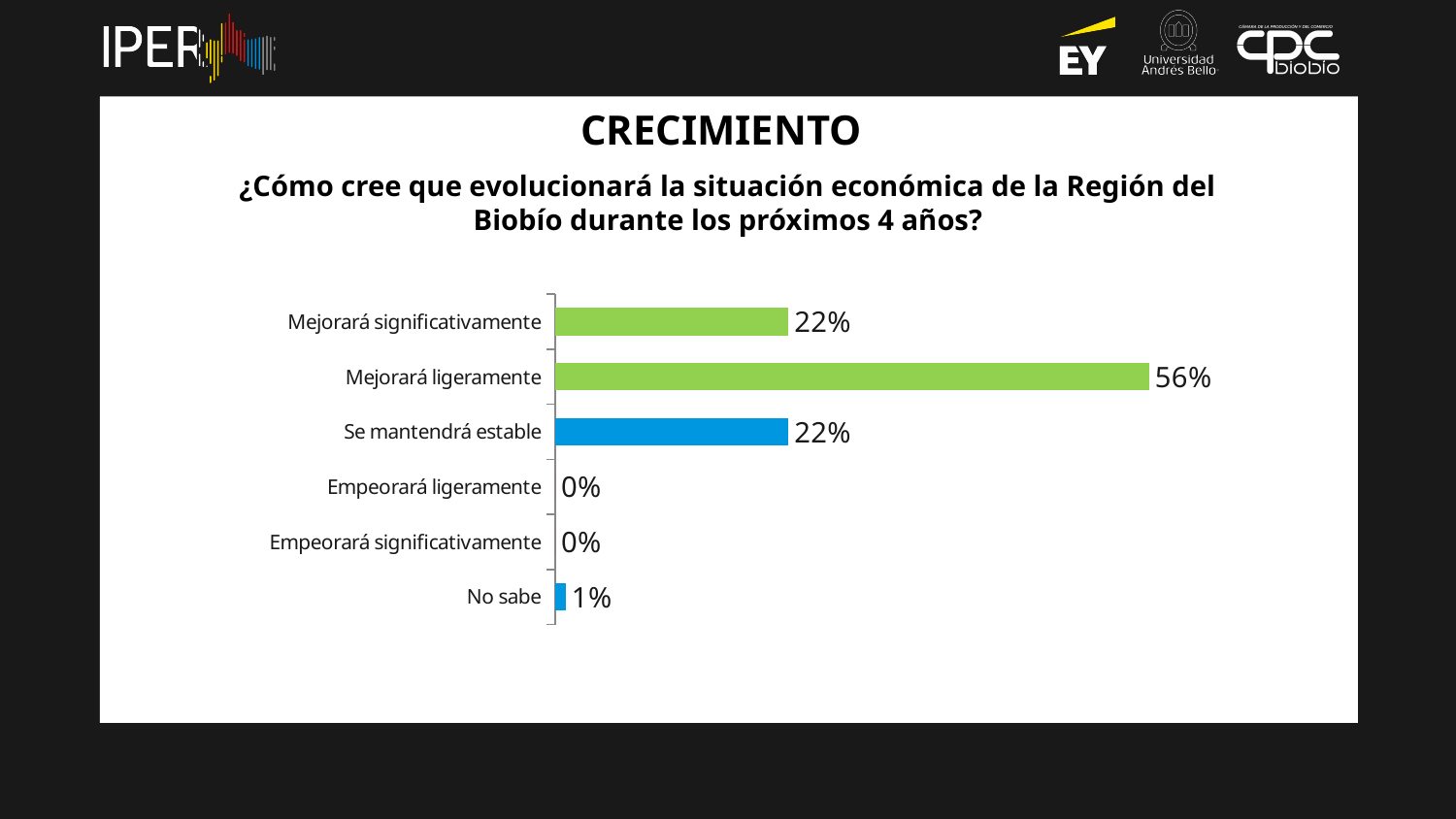
What is the value shown for "Se mantendrá estable"? 22% What is the combined value of "Mejorará significativamente" and "Mejorará ligeramente"? 78% What is the title of the chart section on the slide? CRECIMIENTO What percentage of respondents answered "Mejorará ligeramente"? 56% What kind of chart is shown on the slide? Bar chart What colour is the bar for "Se mantendrá estable"? Blue What is the difference between "Mejorará ligeramente" and "Mejorará significativamente"? 34 percentage points Which category has the highest value? Mejorará ligeramente How many categories are shown in the chart? 6 What is the value shown for "No sabe"? 1% Which is larger: the value for "Mejorará ligeramente" or the value for "Se mantendrá estable"? Mejorará ligeramente What is the value shown for "Empeorará ligeramente"? 0%